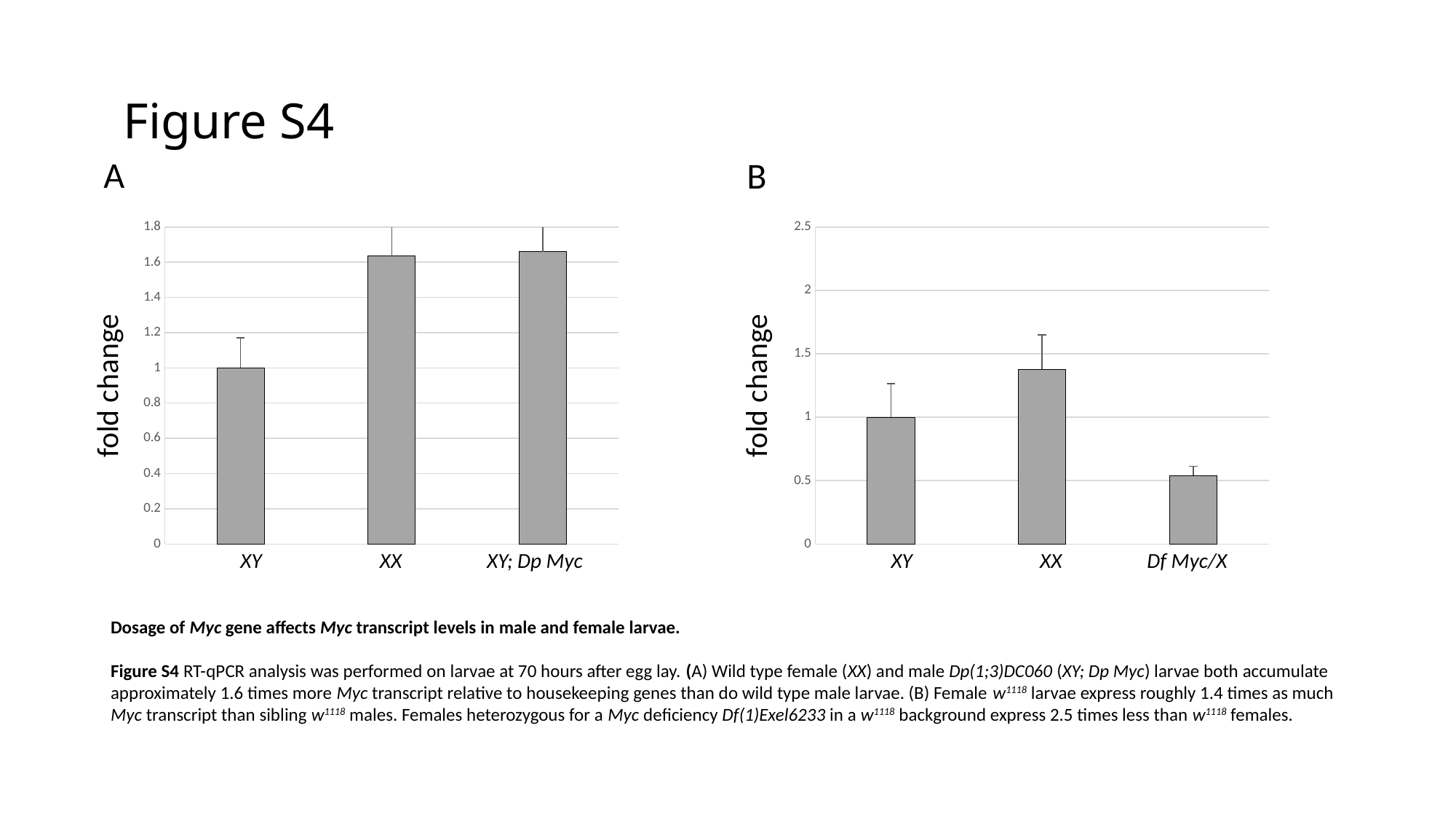
What kind of chart is chart A (left)? bar chart In chart A (left), which has a larger fold change, XY or XX? XX What is the y-axis label of chart B (right)? fold change How many categories are shown in chart B (right)? 3 In chart B (right), which category has the highest fold change? XX In chart B (right), is the fold change for XX greater or less than 1.5? less In chart A (left), what is the fold change for XY? 1 In chart A (left), is the fold change for XX greater or less than 1.4? greater In chart B (right), what is the fold change for XY? 1 In chart B (right), which category has the lowest fold change? Df Myc/X In chart B (right), is the fold change for Df Myc/X greater or less than 1? less In chart A (left), which category has the lowest fold change? XY